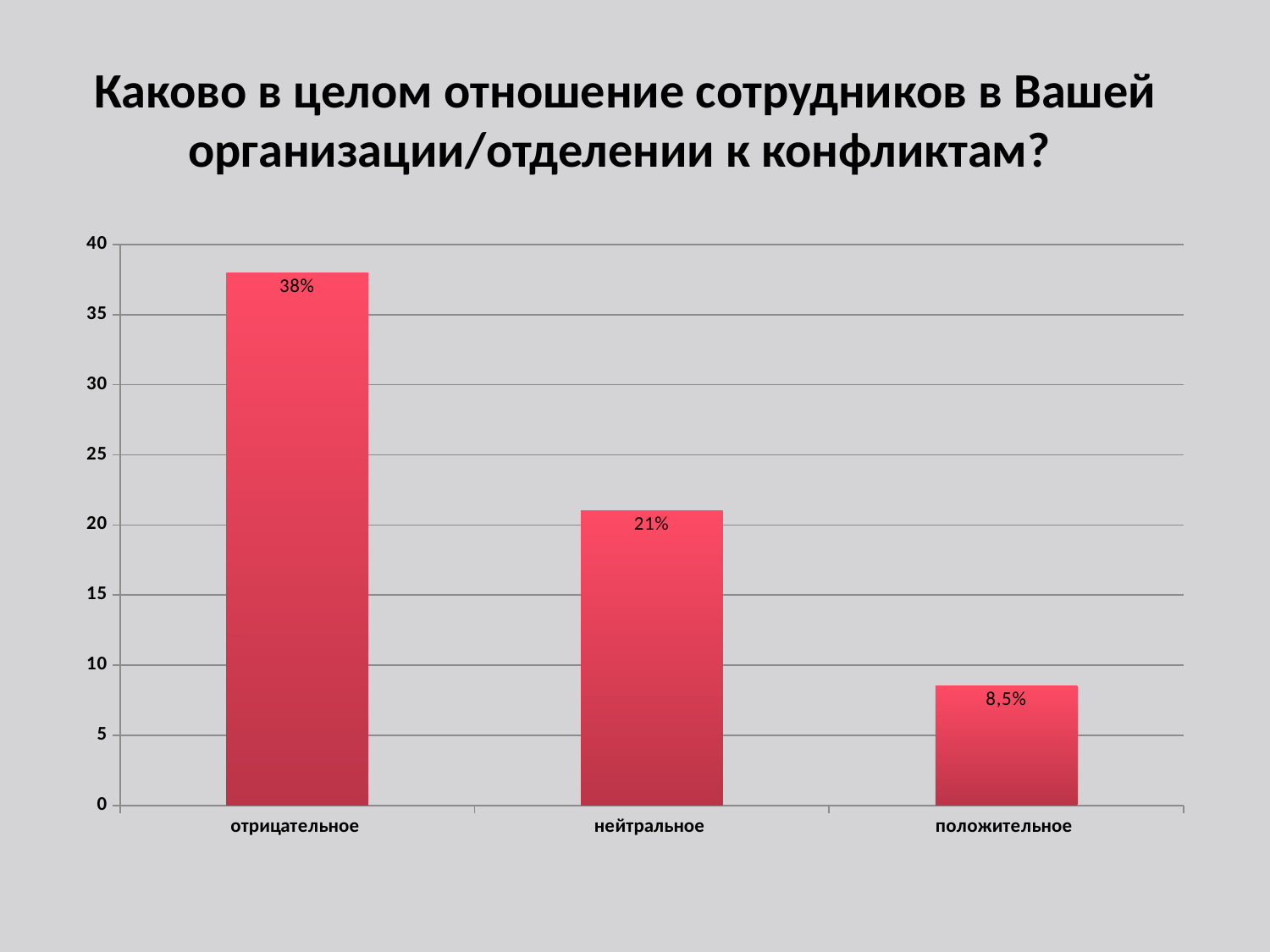
Which is larger, the value for нейтральное or the value for положительное? нейтральное What is the value for положительное? 8,5% What kind of chart is shown on the slide? bar chart Is the value for отрицательное greater or less than 35? greater Do the values rise or fall from left to right along the x axis? fall What is the value for нейтральное? 21% What is the difference between the values for нейтральное and положительное? 12,5% What is the value for отрицательное? 38% Which category has the highest value? отрицательное How many categories are shown on the x axis? 3 What is the difference between the values for отрицательное and нейтральное? 17% Which category has the lowest value? положительное